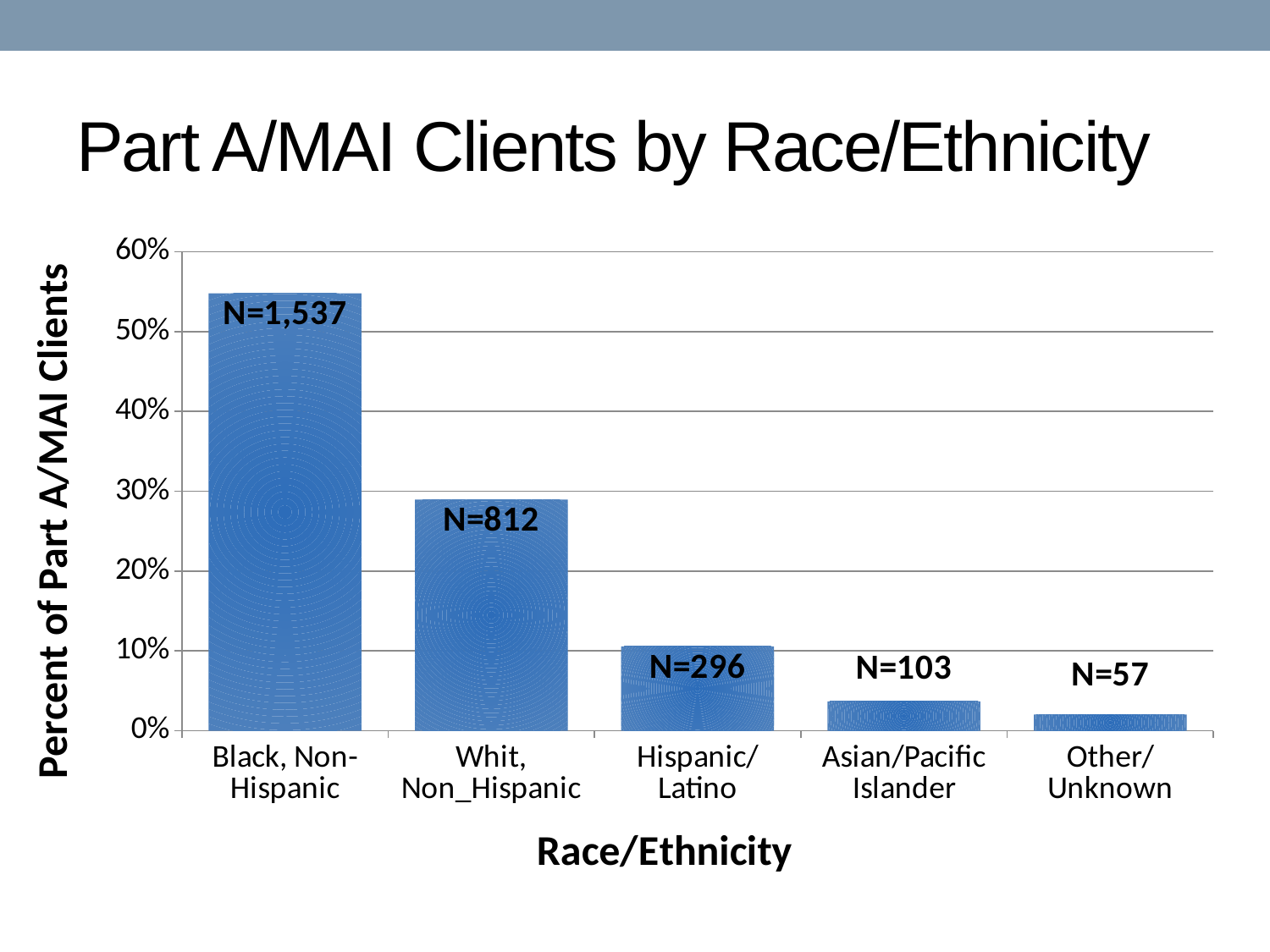
What kind of chart is shown on the slide? bar chart Is the percent of Part A/MAI clients for Whit, Non_Hispanic greater or less than 30%? less How many race/ethnicity categories are shown on the x axis? 5 Is the percent of Part A/MAI clients for Black, Non-Hispanic greater or less than 50%? greater What is the N label shown for Hispanic/Latino? N=296 Which race/ethnicity category has the highest percent of Part A/MAI clients? Black, Non-Hispanic Which has a larger percent of Part A/MAI clients, Hispanic/Latino or Asian/Pacific Islander? Hispanic/Latino What is the N label shown on the bar for Whit, Non_Hispanic? N=812 Which race/ethnicity category has the lowest percent of Part A/MAI clients? Other/Unknown What is the N label shown for Other/Unknown? N=57 What is the N label shown on the bar for Black, Non-Hispanic? N=1,537 What is the N label shown for Asian/Pacific Islander? N=103